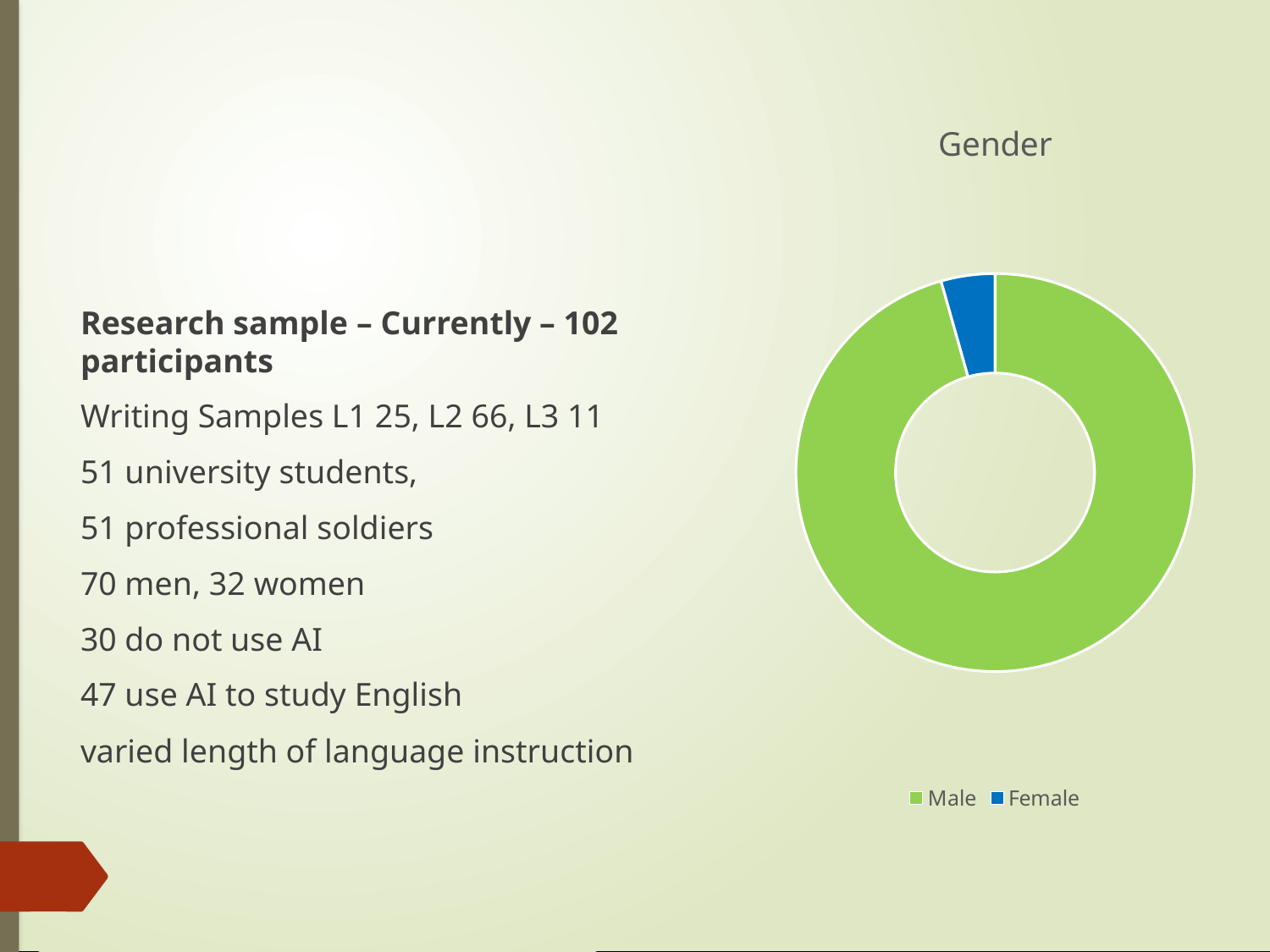
What is the title of the chart? Gender Which category has the largest share in the Gender chart? Male How many entries does the legend of the Gender chart list? 2 How many categories does the Gender chart show? 2 What kind of chart is shown on the slide? doughnut chart In the Gender chart, which is larger, the Male slice or the Female slice? Male Which colour represents Female in the Gender chart? blue Which category has the smallest share in the Gender chart? Female